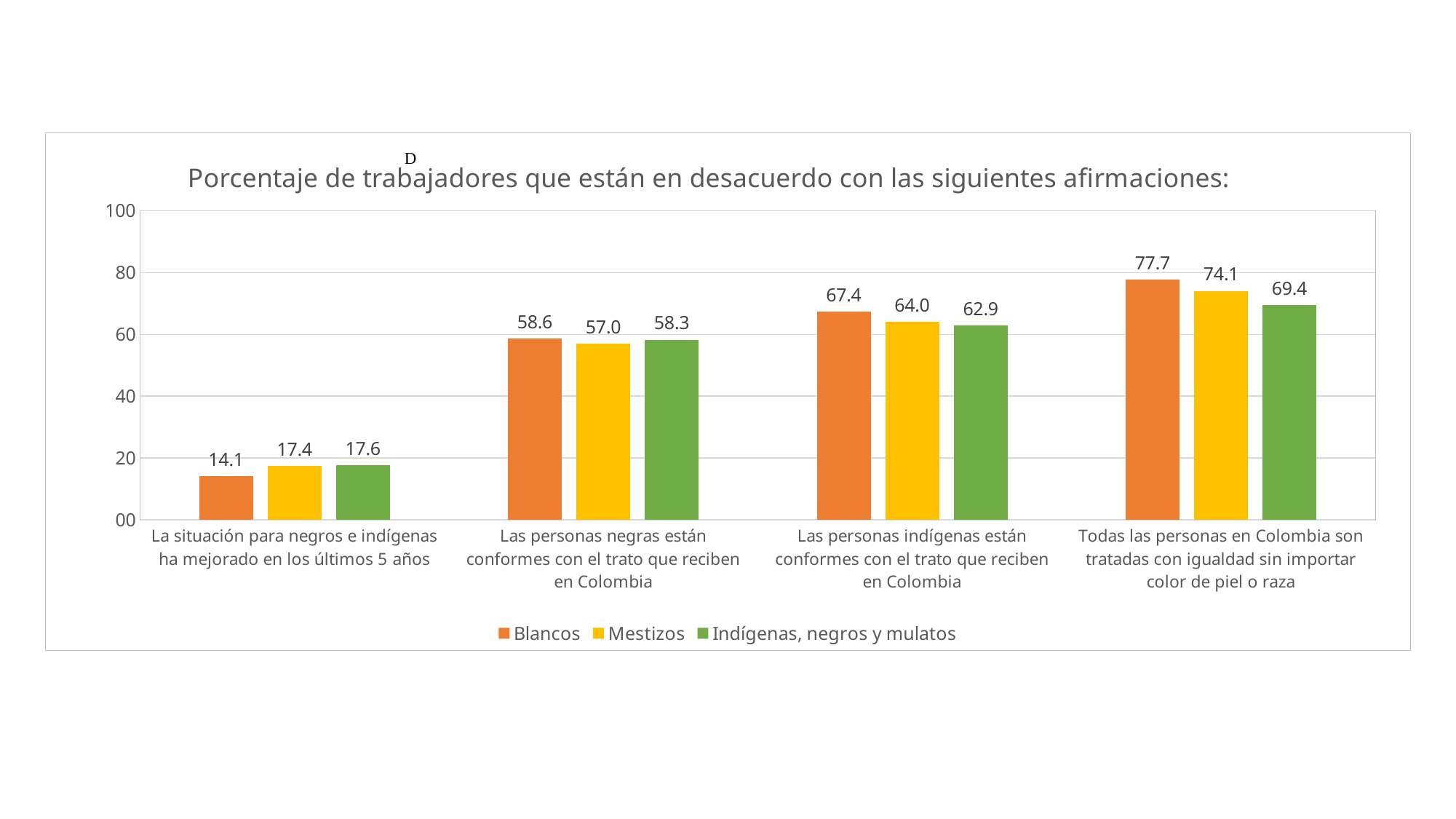
Which colour represents the Mestizos series? Yellow What is the value for Indígenas, negros y mulatos for the statement "Todas las personas en Colombia son tratadas con igualdad sin importar color de piel o raza"? 69.4 Which statement has the lowest value for Mestizos? La situación para negros e indígenas ha mejorado en los últimos 5 años How many statements (categories) are shown on the x axis? 4 For the statement "Las personas indígenas están conformes con el trato que reciben en Colombia", which is larger: the value for Blancos or for Indígenas, negros y mulatos? Blancos Is the value for Mestizos for the statement "Las personas indígenas están conformes con el trato que reciben en Colombia" greater or less than 60? greater What is the value for Blancos for the statement "La situación para negros e indígenas ha mejorado en los últimos 5 años"? 14.1 What kind of chart is shown on the slide? Bar chart What is the value for Mestizos for the statement "Las personas negras están conformes con el trato que reciben en Colombia"? 57.0 What is the difference between the Blancos and Mestizos values for the statement "Todas las personas en Colombia son tratadas con igualdad sin importar color de piel o raza"? 3.6 Which statement has the highest value for Blancos? Todas las personas en Colombia son tratadas con igualdad sin importar color de piel o raza How many series does the legend list? 3